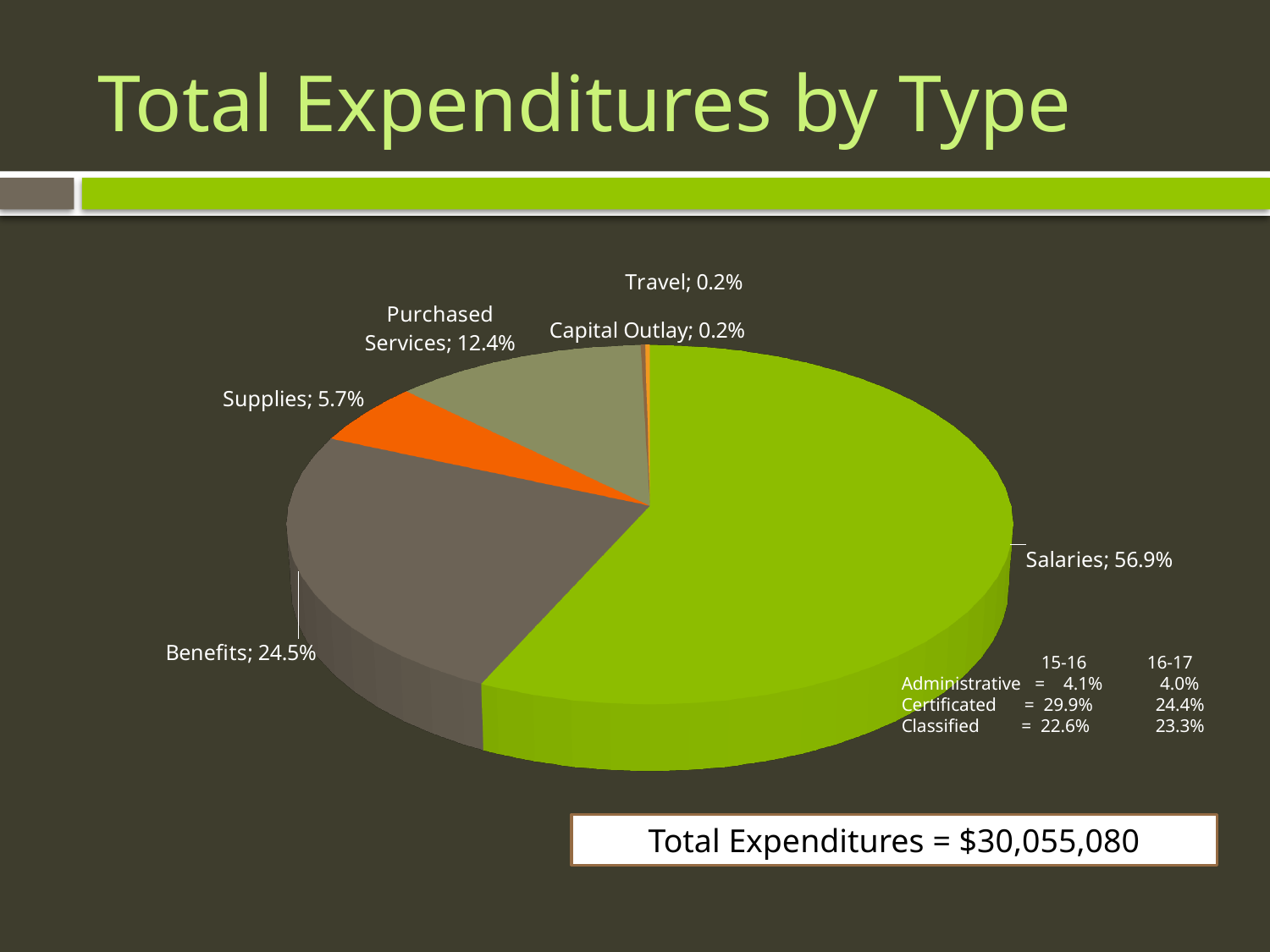
What is the title of the chart? Total Expenditures by Type What is the difference in percentage points between the Salaries and Benefits shares? 32.4 Which is larger, the share for Supplies or the share for Purchased Services? Purchased Services What is the total expenditures amount shown on the slide? $30,055,080 What share of total expenditures is Salaries? 56.9% What share of total expenditures is Supplies? 5.7% What share of total expenditures is Benefits? 24.5% Which expenditure type has the largest share of the pie? Salaries What kind of chart is shown on the slide? Pie chart How many expenditure types are shown in the pie chart? 6